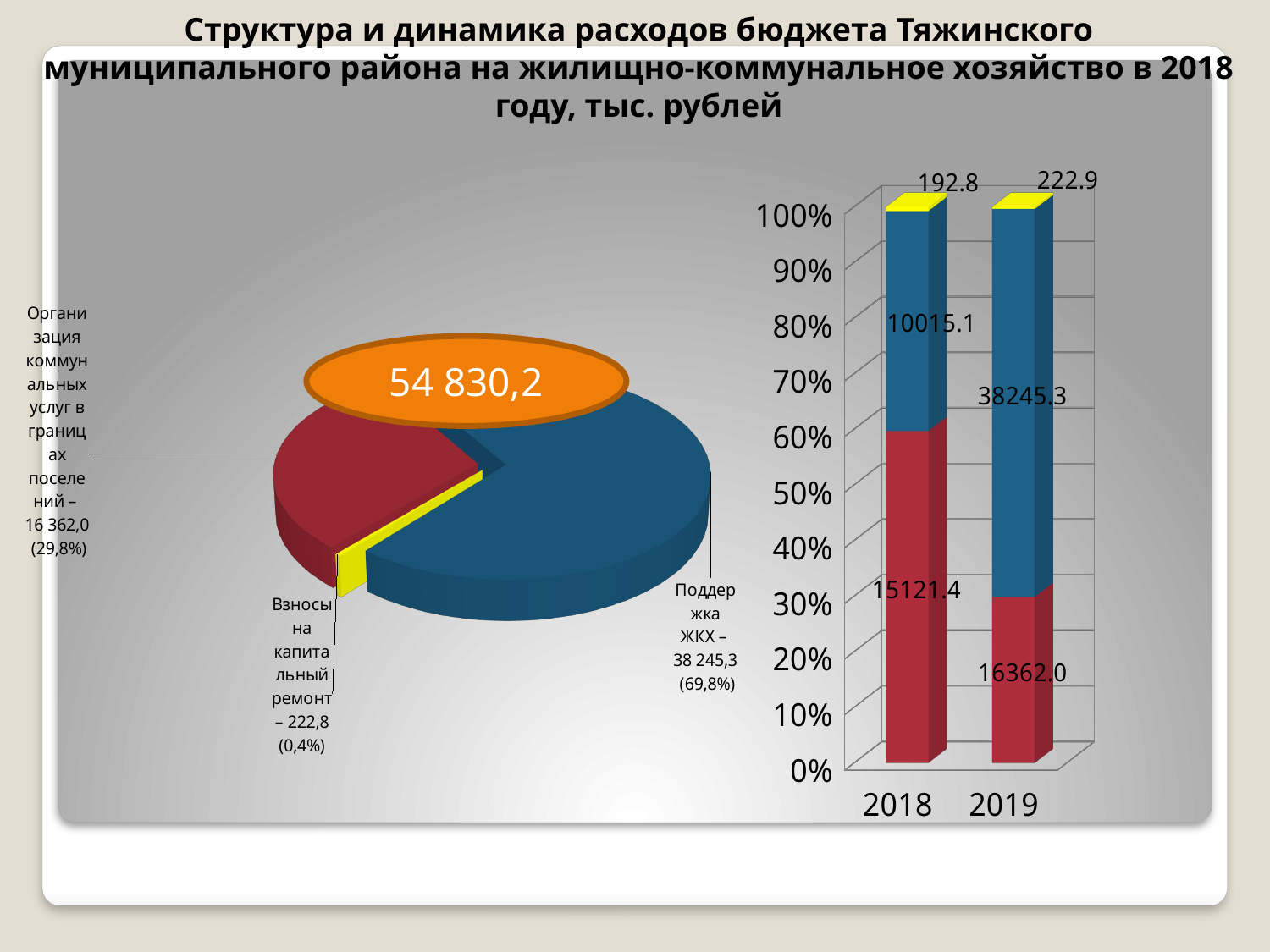
How many slices does the pie chart on the left have? 3 On the pie chart on the left, what is the value shown for Поддержка ЖКХ? 38 245,3 On the pie chart on the left, which category has the smallest slice? Взносы на капитальный ремонт On the pie chart on the left, what share of the total does Организация коммунальных услуг в границах поселений represent? 29,8% On the stacked bar chart on the right, what is the value of the yellow segment for 2018? 192.8 On the stacked bar chart on the right, what is the value of the blue segment for 2019? 38245.3 On the pie chart on the left, what share of the total does Взносы на капитальный ремонт represent? 0,4% On the stacked bar chart on the right, what is the difference between the blue segment values for 2019 and 2018? 28230.2 On the stacked bar chart on the right, what is the value of the red segment for 2018? 15121.4 What type of chart is shown on the right side of the slide? Stacked bar chart On the pie chart on the left, what total value is shown in the orange oval? 54 830,2 On the pie chart on the left, which category has the largest slice? Поддержка ЖКХ